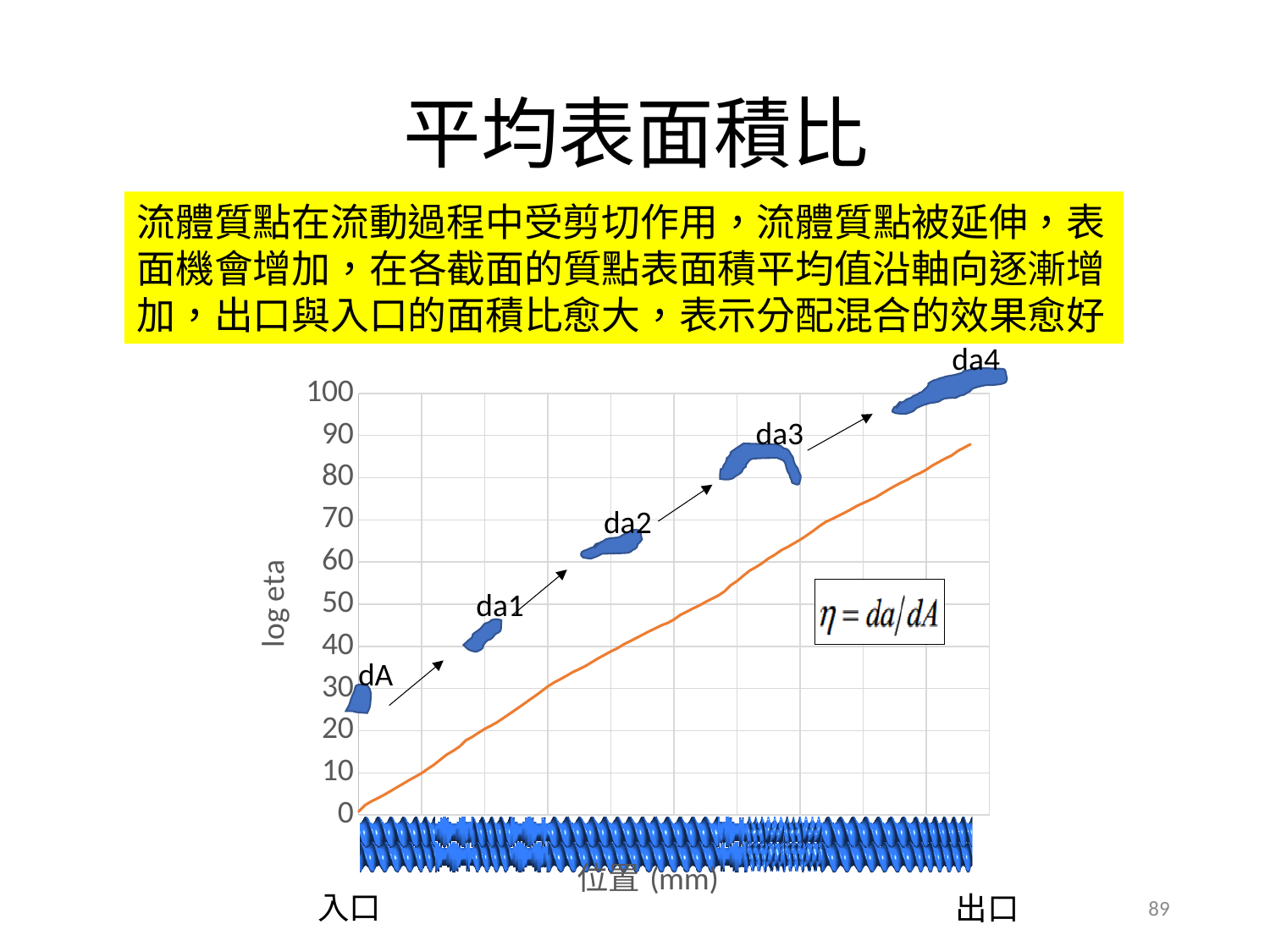
What is the label of the horizontal axis of the chart? 位置 (mm) What is the label of the vertical axis of the chart? log eta What kind of chart is shown on the slide? line chart Which end of the orange line has the larger value, the inlet (入口) end or the outlet (出口) end? outlet (出口) end What is the highest tick value shown on the vertical axis? 100 Is the value of the orange line at the inlet end (left end) greater or less than 10? less Do the plotted values rise or fall from the inlet (入口) to the outlet (出口) along the x axis? rise Is the value of the orange line at the outlet end (right end) greater or less than 100? less Is the value of the orange line at the outlet end (right end) greater or less than 80? greater